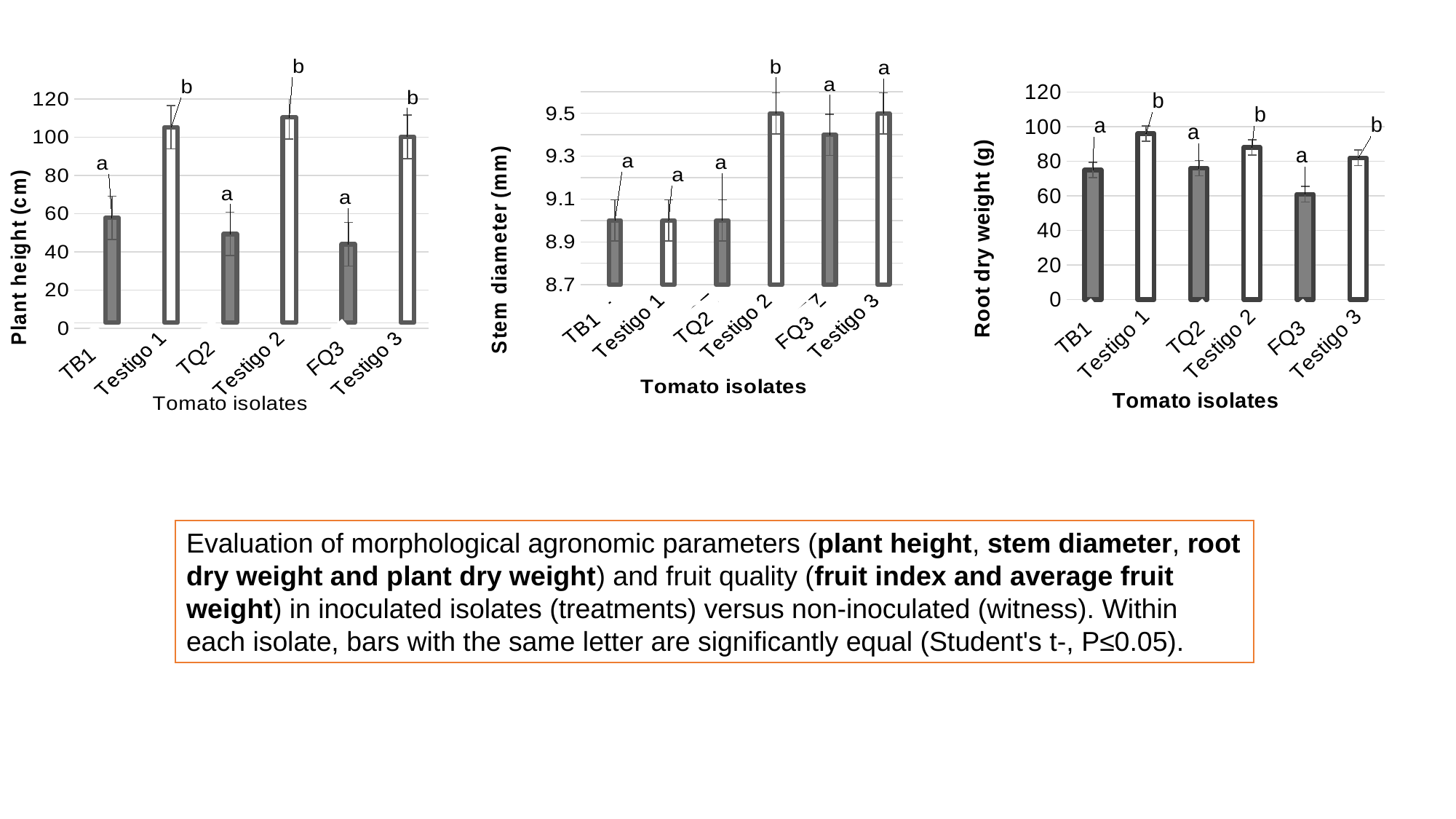
In the Root dry weight (g) chart, which is larger, the value for Testigo 2 or the value for FQ3? Testigo 2 How many categories are shown on the x axis of the Stem diameter (mm) chart? 6 In the Stem diameter (mm) chart, is the value for FQ3 greater or less than 9.3? greater In the Plant height (cm) chart, which is larger, the value for Testigo 1 or the value for TB1? Testigo 1 In the Stem diameter (mm) chart, what is the value for Testigo 2? 9.5 In the Plant height (cm) chart, is the value for FQ3 greater or less than 60? less In the Root dry weight (g) chart, which category has the highest value? Testigo 1 In the Root dry weight (g) chart, is the value for FQ3 greater or less than 80? less What kind of chart is the Root dry weight (g) chart? bar chart In the Root dry weight (g) chart, which category has the lowest value? FQ3